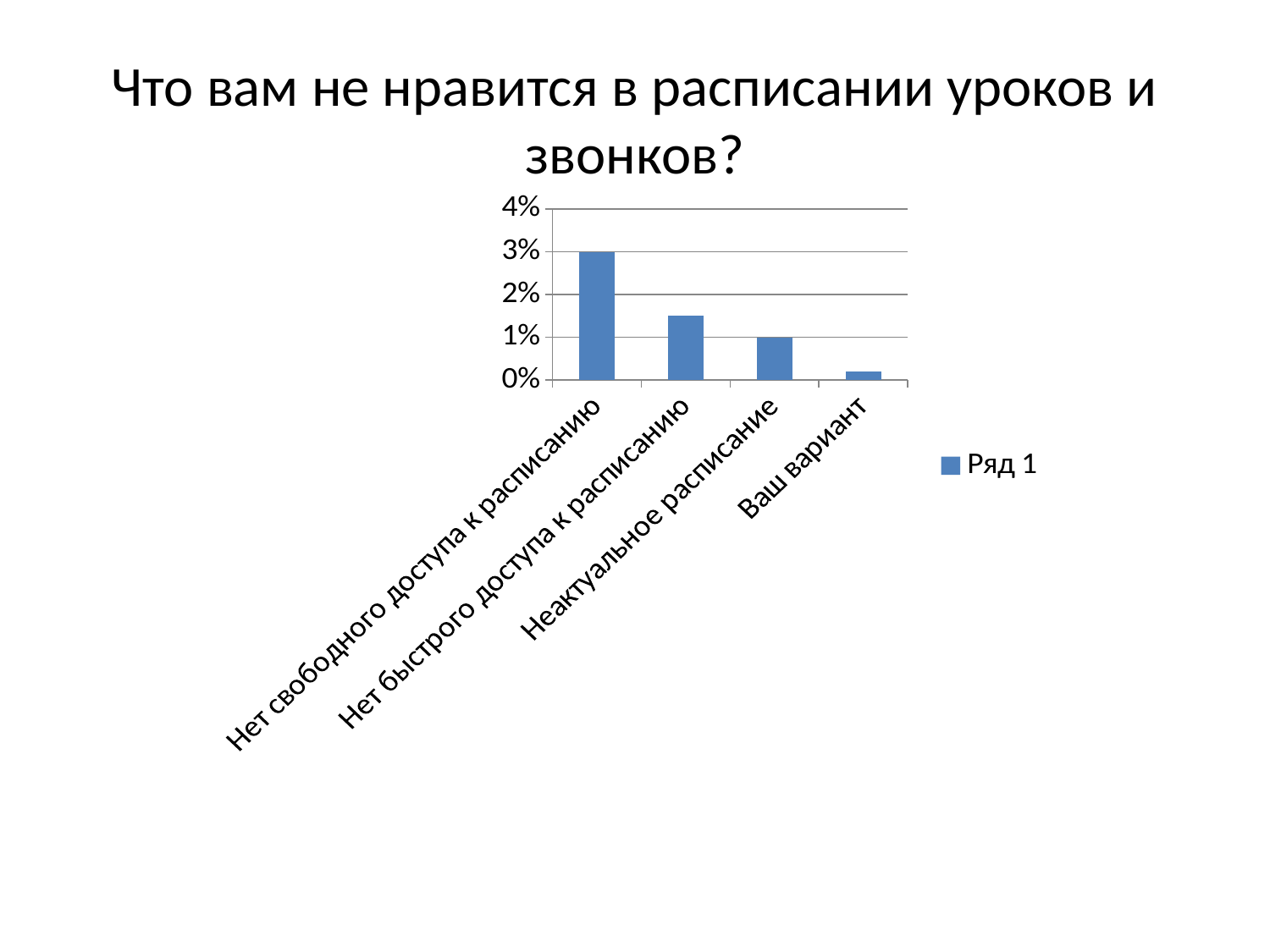
Which category has the lowest value? Ваш вариант What kind of chart is shown on the slide? bar chart Do the values rise or fall from left to right along the x axis? fall How many series does the chart legend list? 1 Which category has the highest value? Нет свободного доступа к расписанию Is the value for "Ваш вариант" greater or less than 1%? less Which is larger: the value for "Нет быстрого доступа к расписанию" or the value for "Неактуальное расписание"? Нет быстрого доступа к расписанию What is the name of the series shown in the legend? Ряд 1 What is the value for "Нет свободного доступа к расписанию"? 3% What is the value for "Неактуальное расписание"? 1% How many categories are shown on the x axis of the chart? 4 Is the value for "Нет быстрого доступа к расписанию" greater or less than 1%? greater